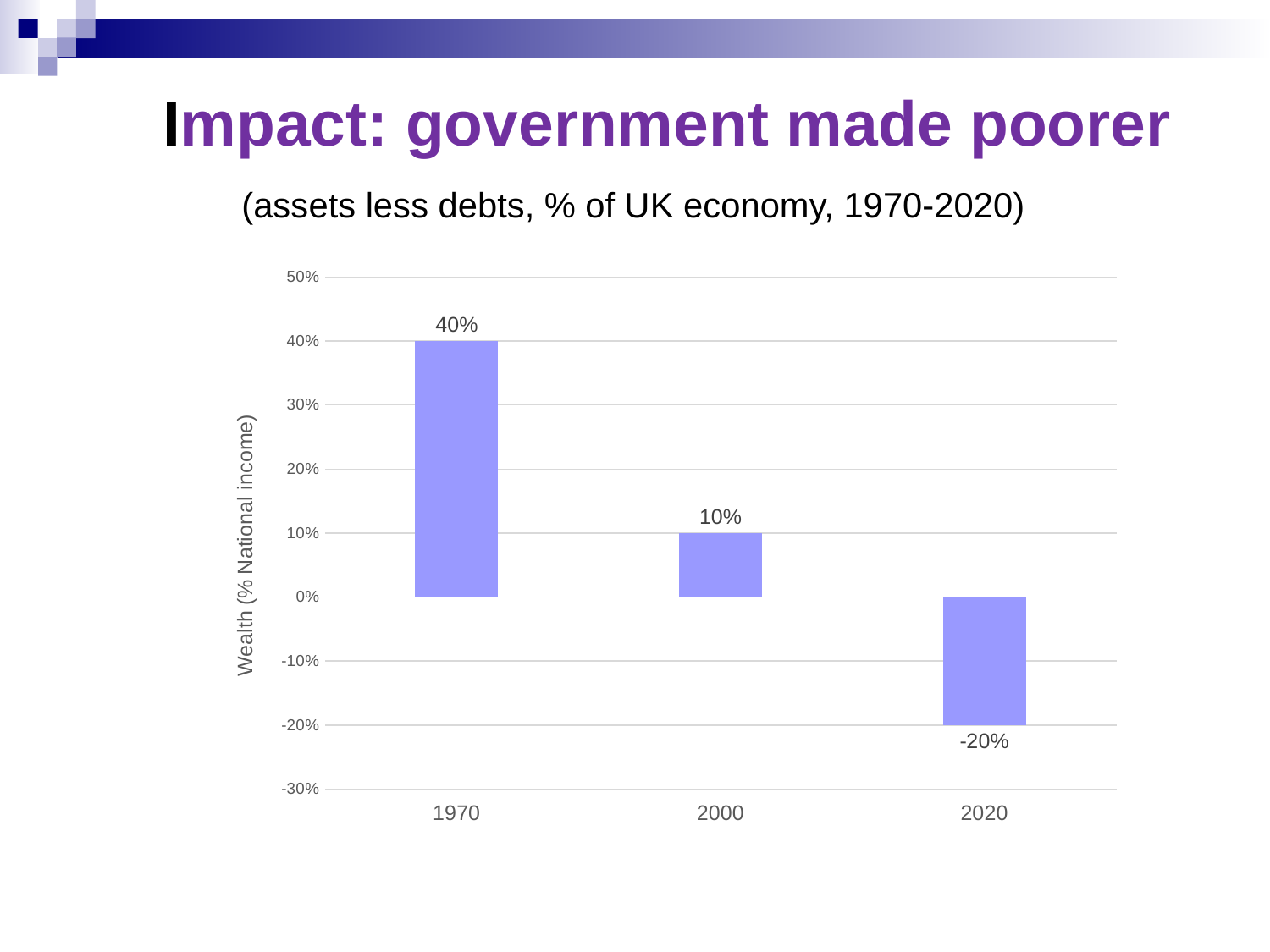
Which year has the highest value? 1970 What is the value for 2020? -20% What is the value for 1970? 40% What is the difference between the values for 2000 and 2020? 30% What is the difference between the values for 1970 and 2000? 30% What is the value for 2000? 10% Which year has the lowest value? 2020 What is the label of the y axis? Wealth (% National income) Do the values rise or fall from 1970 to 2020? fall How many years are shown on the x axis? 3 Which is larger, the value for 2000 or the value for 2020? 2000 What kind of chart is shown? bar chart